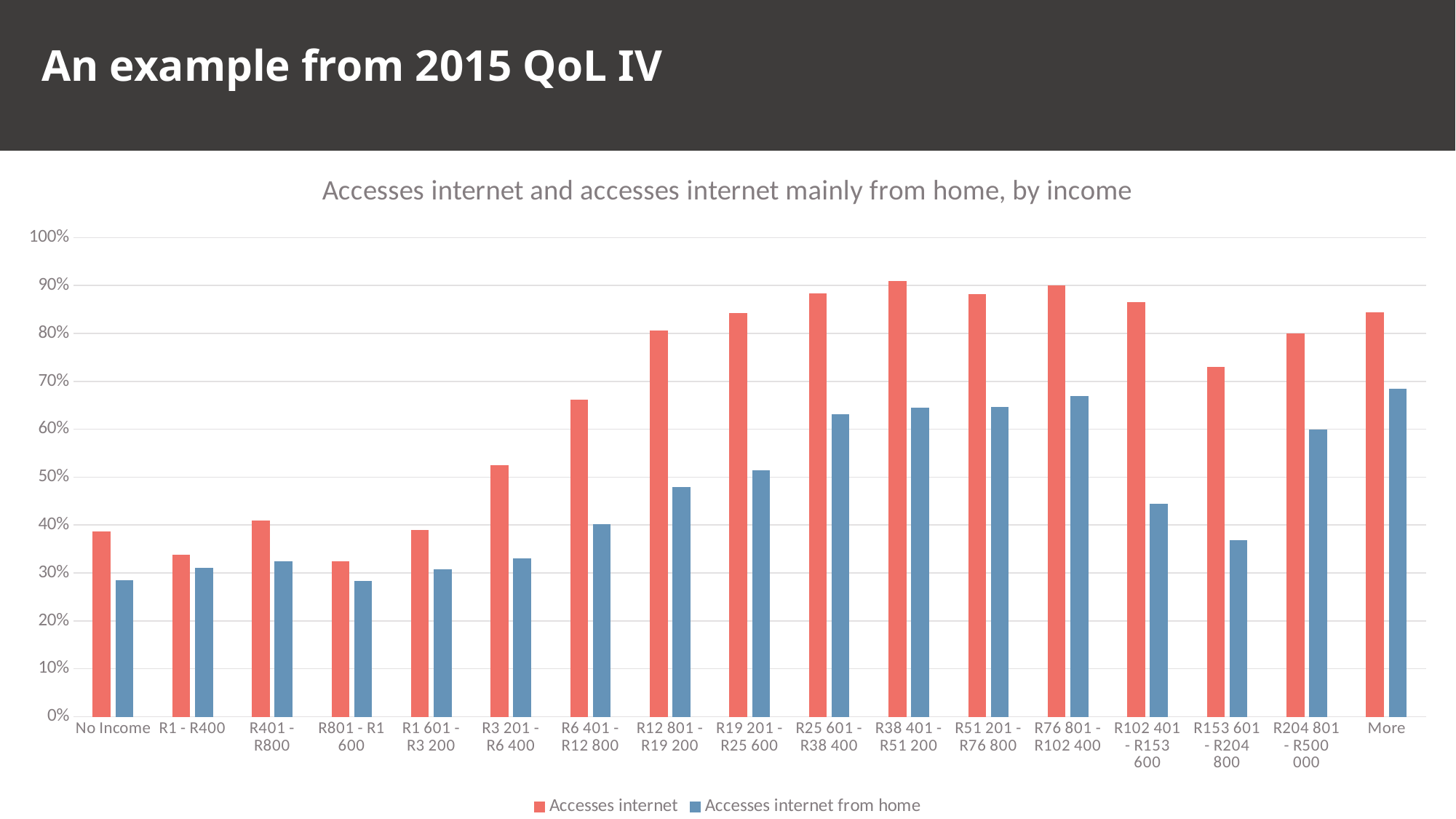
Is the 'Accesses internet from home' value for R102 401 - R153 600 greater or less than 40%? greater Which has the larger 'Accesses internet' value: R12 801 - R19 200 or R3 201 - R6 400? R12 801 - R19 200 Is the 'Accesses internet' value for R153 601 - R204 800 greater or less than 70%? greater What is the title of the chart? Accesses internet and accesses internet mainly from home, by income Do the 'Accesses internet' values generally rise or fall from No Income to R38 401 - R51 200? rise How many income categories are shown on the x axis? 17 Is the 'Accesses internet from home' value for R25 601 - R38 400 greater or less than 60%? greater What kind of chart is shown on the slide? Bar chart How many series does the legend list? 2 Which has the larger 'Accesses internet from home' value: R401 - R800 or R6 401 - R12 800? R6 401 - R12 800